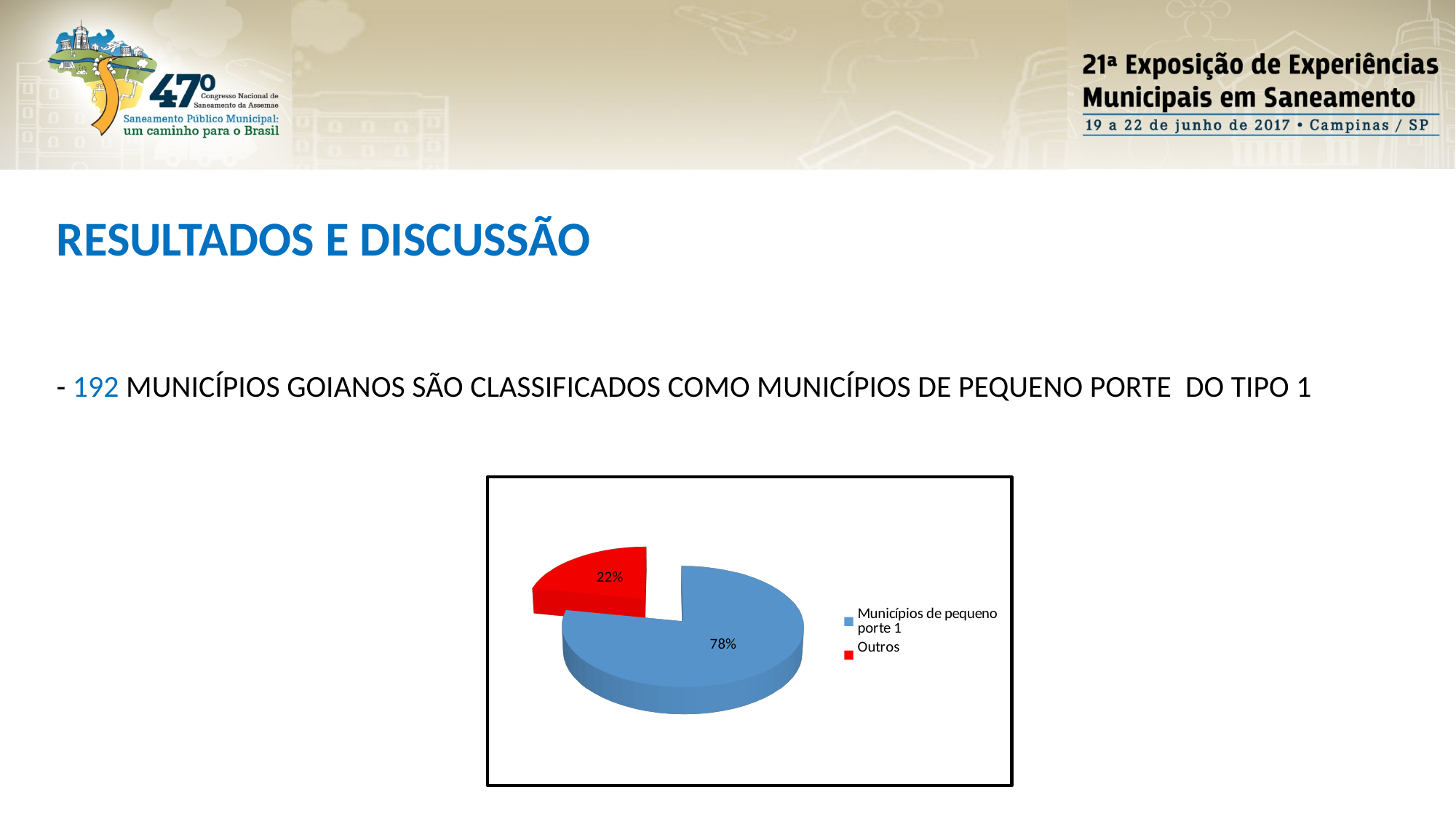
What colour is the "Outros" slice? red Which is larger: the "Outros" slice or the "Municípios de pequeno porte 1" slice? Municípios de pequeno porte 1 What kind of chart is shown on the slide? pie chart How many entries does the legend list? 2 Which slice of the pie is the smallest? Outros How many slices does the pie chart have? 2 What share of the pie is labelled "Municípios de pequeno porte 1"? 78% What colour is the "Municípios de pequeno porte 1" slice? blue Which slice of the pie is the largest? Municípios de pequeno porte 1 What is the difference in percentage points between the "Municípios de pequeno porte 1" slice and the "Outros" slice? 56 What share of the pie is labelled "Outros"? 22%